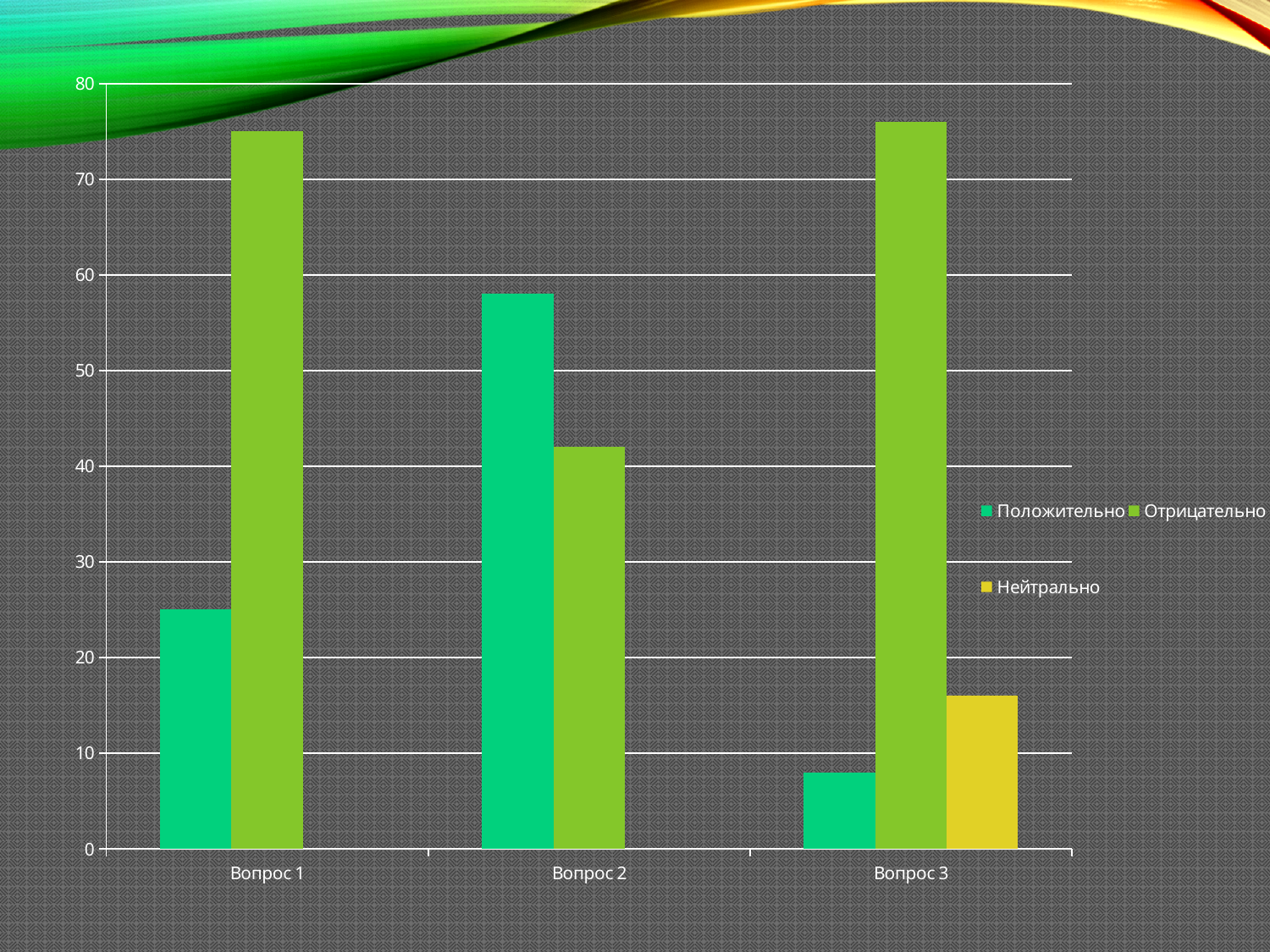
What kind of chart is shown on the slide? bar chart Is the value for Положительно in Вопрос 1 greater or less than 30? less Which category has the lowest value for Отрицательно? Вопрос 2 Which category has the highest value for Положительно? Вопрос 2 Is the value for Отрицательно in Вопрос 2 greater or less than 50? less Which category is the only one with a bar for Нейтрально? Вопрос 3 Is the value for Отрицательно in Вопрос 1 greater or less than 70? greater How many categories are shown on the x axis? 3 How many series does the legend list? 3 In Вопрос 2, which is larger: Положительно or Отрицательно? Положительно